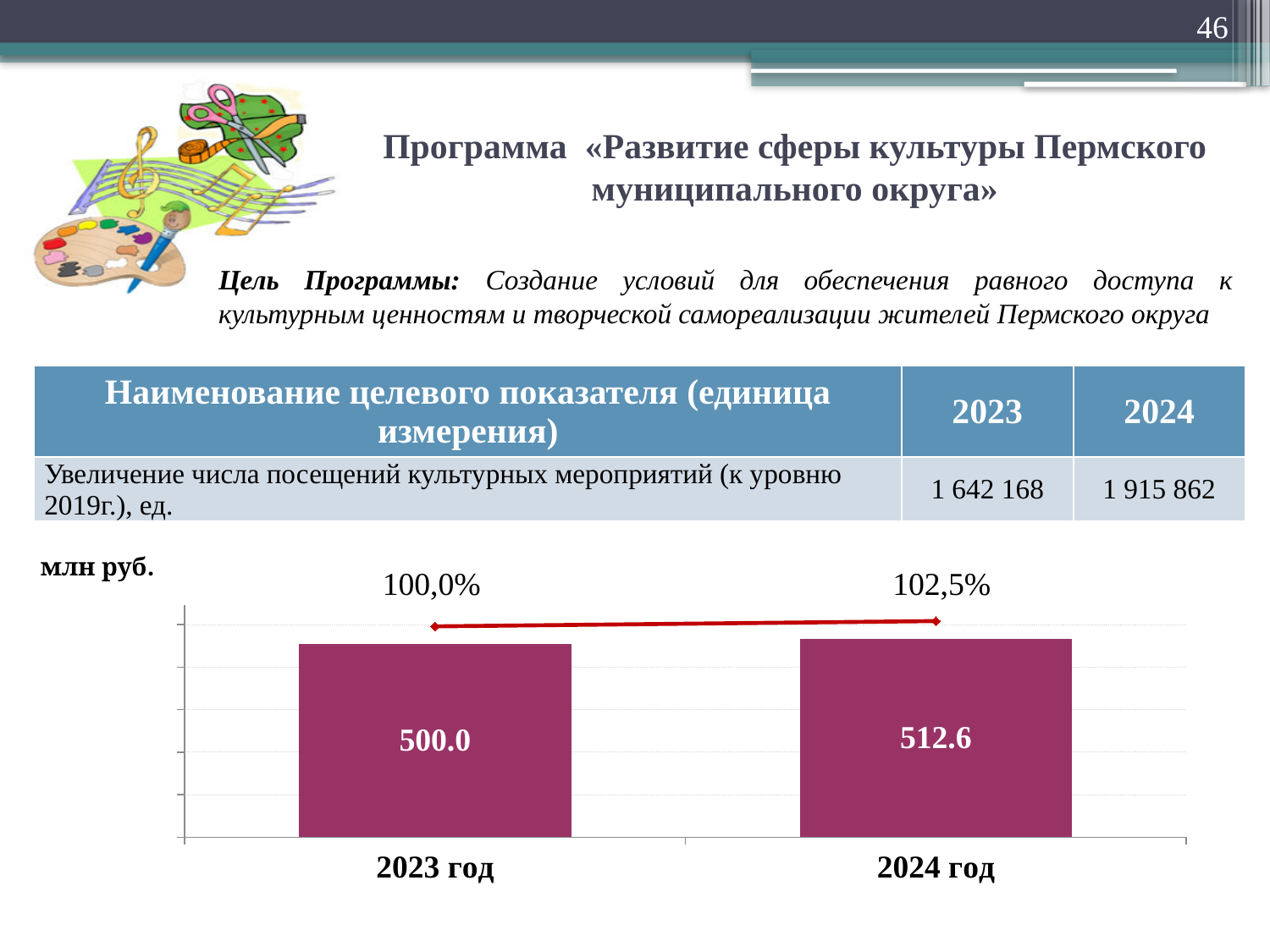
What unit is indicated for the chart values? млн руб. What is the value for 2023 год in the bar chart? 500.0 Is the bar value for 2024 год larger or smaller than the bar value for 2023 год? larger What percentage label is shown above the 2024 год bar on the line? 102,5% What percentage label is shown above the 2023 год bar on the line? 100,0% What is the value for 2024 год in the bar chart? 512.6 Which year has the higher bar in the chart? 2024 год What is the difference between the 2024 год and 2023 год bar values? 12.6 What kind of chart is shown on the slide? combination bar and line chart How many bars are shown in the chart? 2 Do the bar values rise or fall from 2023 год to 2024 год? rise Which year has the lower bar in the chart? 2023 год